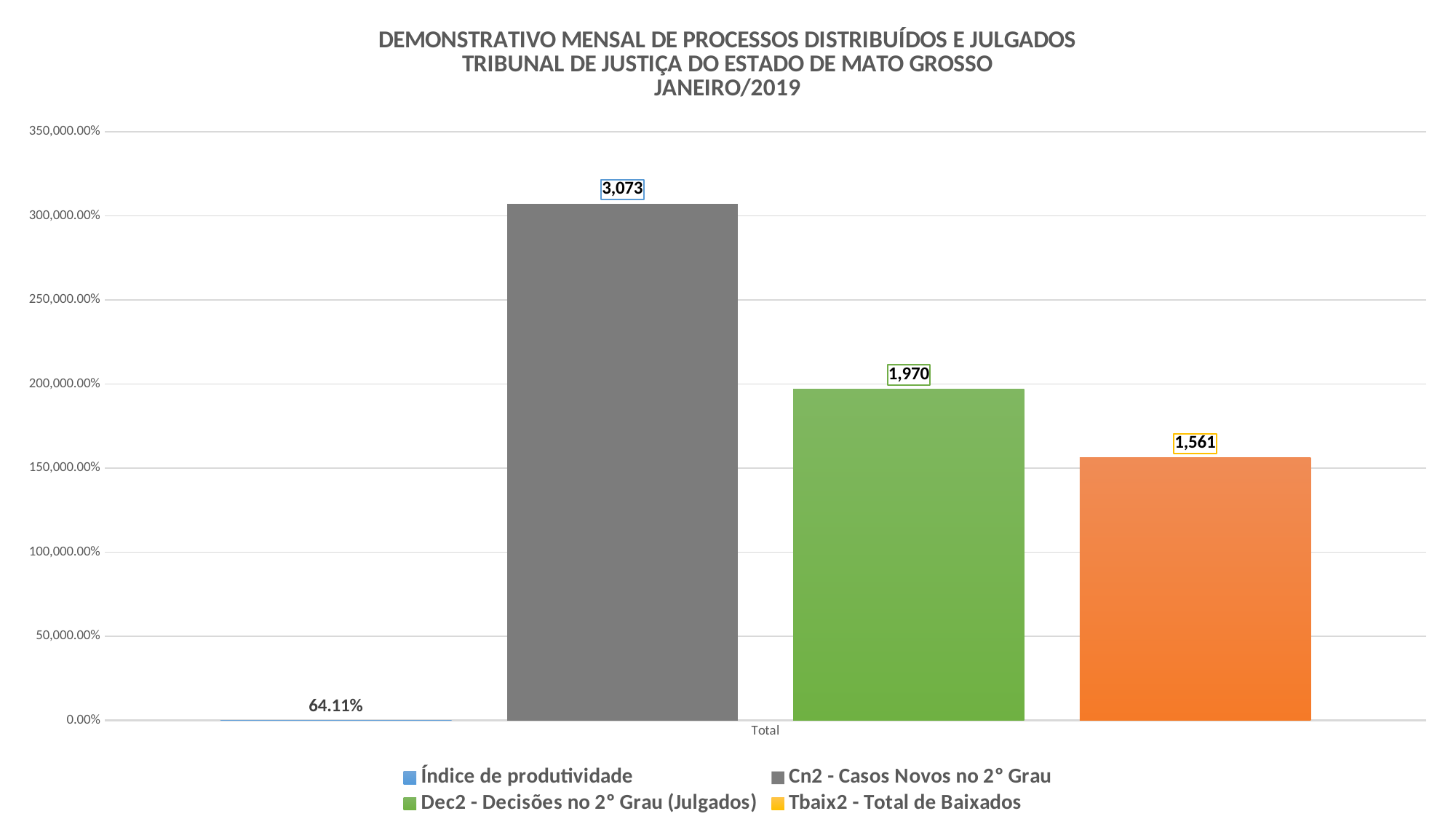
What is the difference between the Dec2 - Decisões no 2° Grau (Julgados) value and the Tbaix2 - Total de Baixados value? 409 What is the difference between the Cn2 - Casos Novos no 2° Grau value and the Dec2 - Decisões no 2° Grau (Julgados) value? 1,103 What is the value shown for Tbaix2 - Total de Baixados? 1,561 What is the value shown for Dec2 - Decisões no 2° Grau (Julgados)? 1,970 What is the value shown for Cn2 - Casos Novos no 2° Grau? 3,073 What is the value shown for Índice de produtividade? 64.11% Which series has the smallest value? Índice de produtividade Which series has the tallest bar? Cn2 - Casos Novos no 2° Grau What is the category label shown on the x axis? Total What kind of chart is shown on the slide? Bar chart Which is larger, the value for Dec2 - Decisões no 2° Grau (Julgados) or the value for Tbaix2 - Total de Baixados? Dec2 - Decisões no 2° Grau (Julgados) How many series does the legend list? 4